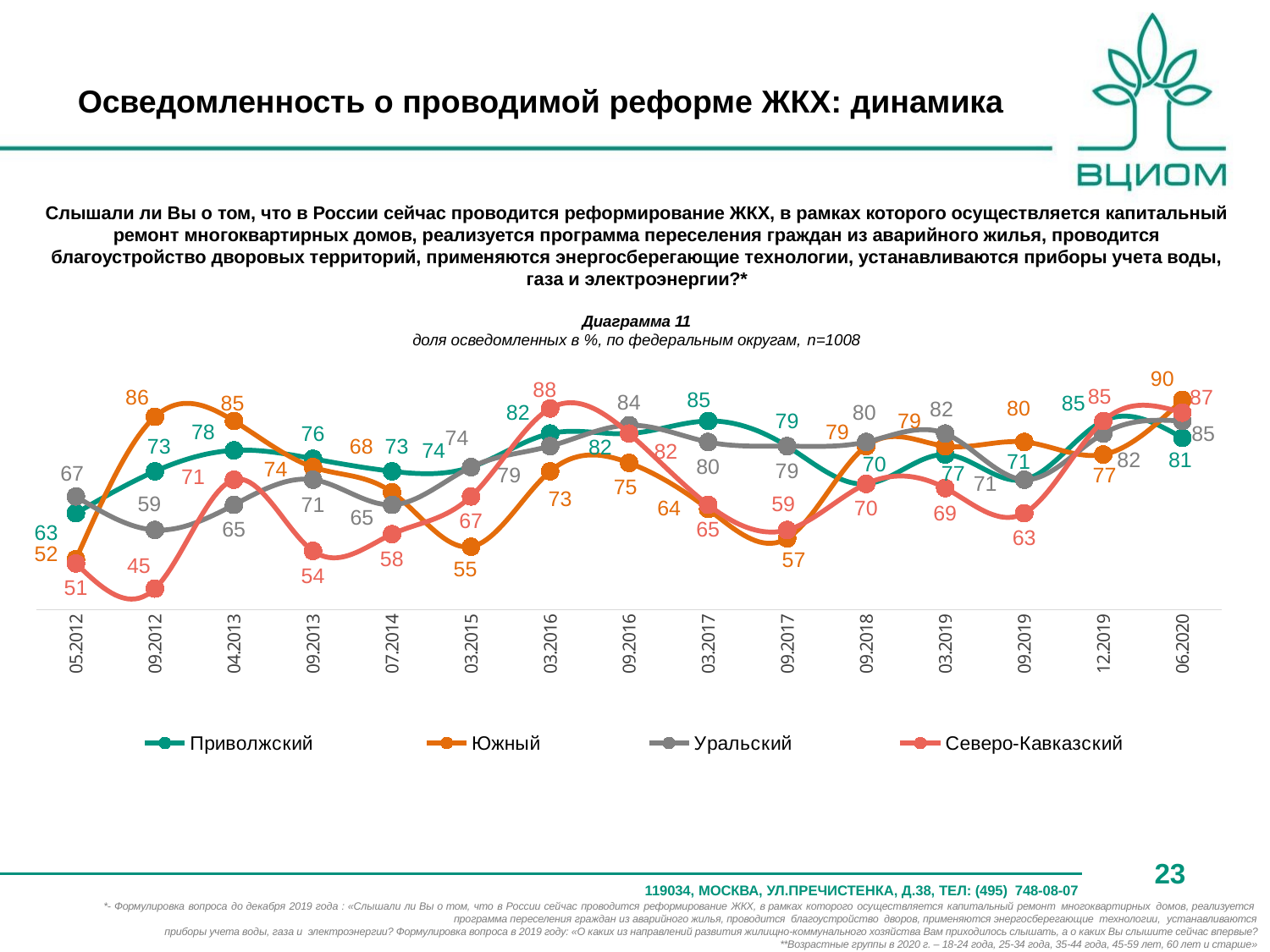
What is the value for Приволжский at 03.2017? 85 What is the value for Южный at 06.2020? 90 What kind of chart is shown on the slide? line chart How many time points are shown on the x axis? 15 At which time point does Северо-Кавказский have its lowest value? 09.2012 Which is larger at 09.2017: Приволжский or Южный? Приволжский What is the difference between Южный and Северо-Кавказский at 09.2012? 41 What is the value for Северо-Кавказский at 09.2012? 45 Which series is shown in orange in the legend? Южный At which time point does Южный reach its highest value? 06.2020 What is the value for Уральский at 05.2012? 67 How many series does the legend list? 4